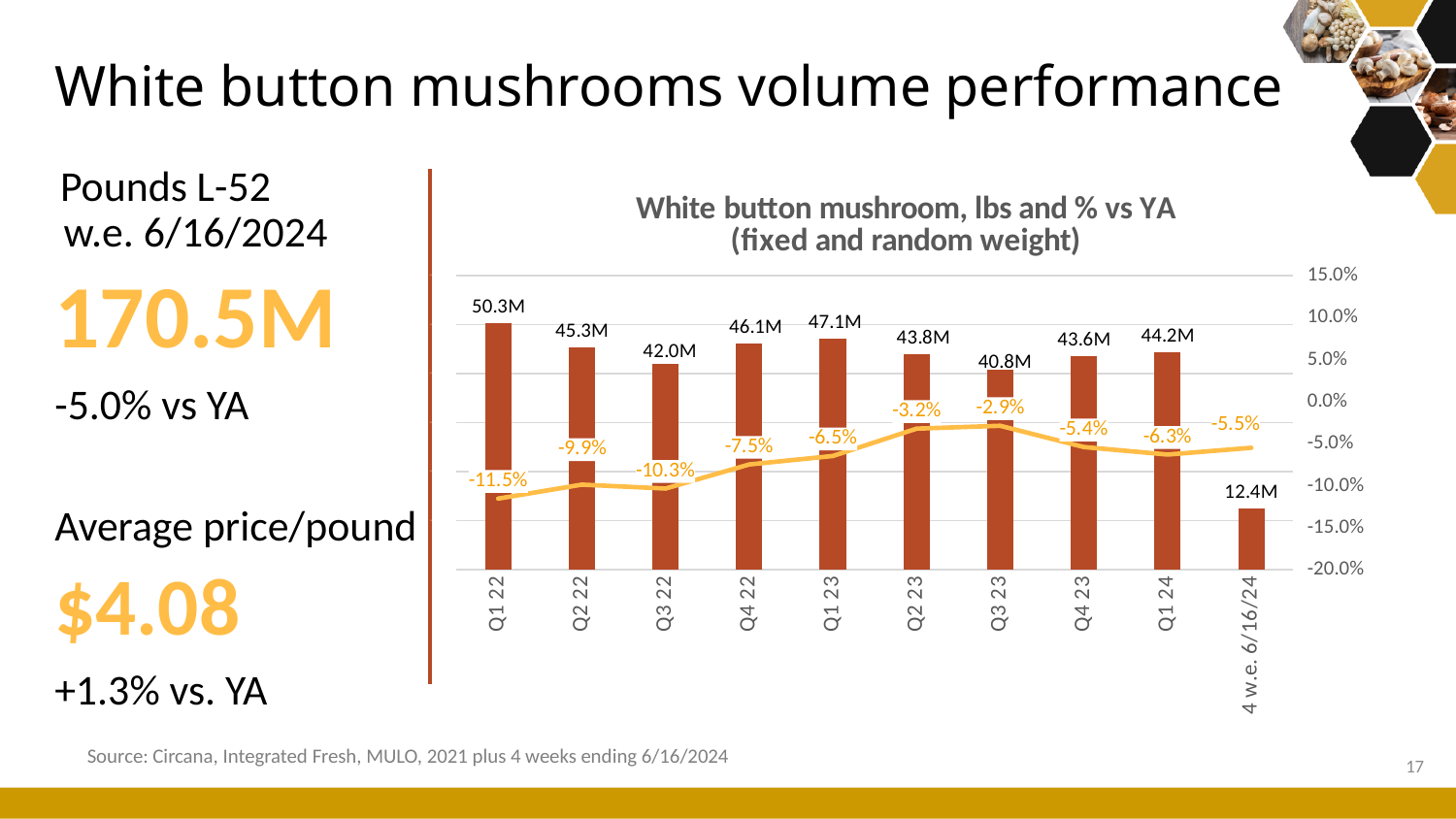
What is the volume in pounds for Q1 22? 50.3M What is the % vs YA value for Q3 23? -2.9% Which is larger, the volume for Q4 22 or Q3 22? Q4 22 What kind of chart is this? Combined bar and line chart What is the % vs YA value for Q1 22? -11.5% What is the title of the chart? White button mushroom, lbs and % vs YA (fixed and random weight) Which quarter has the lowest % vs YA value? Q1 22 What is the difference in pounds between Q1 23 and Q2 23? 3.3M Does the % vs YA line generally rise or fall from Q1 22 to Q3 23? Rise How many periods are shown on the x axis? 10 What is the volume in pounds for the 4 w.e. 6/16/24 period? 12.4M Which period has the highest volume in pounds? Q1 22